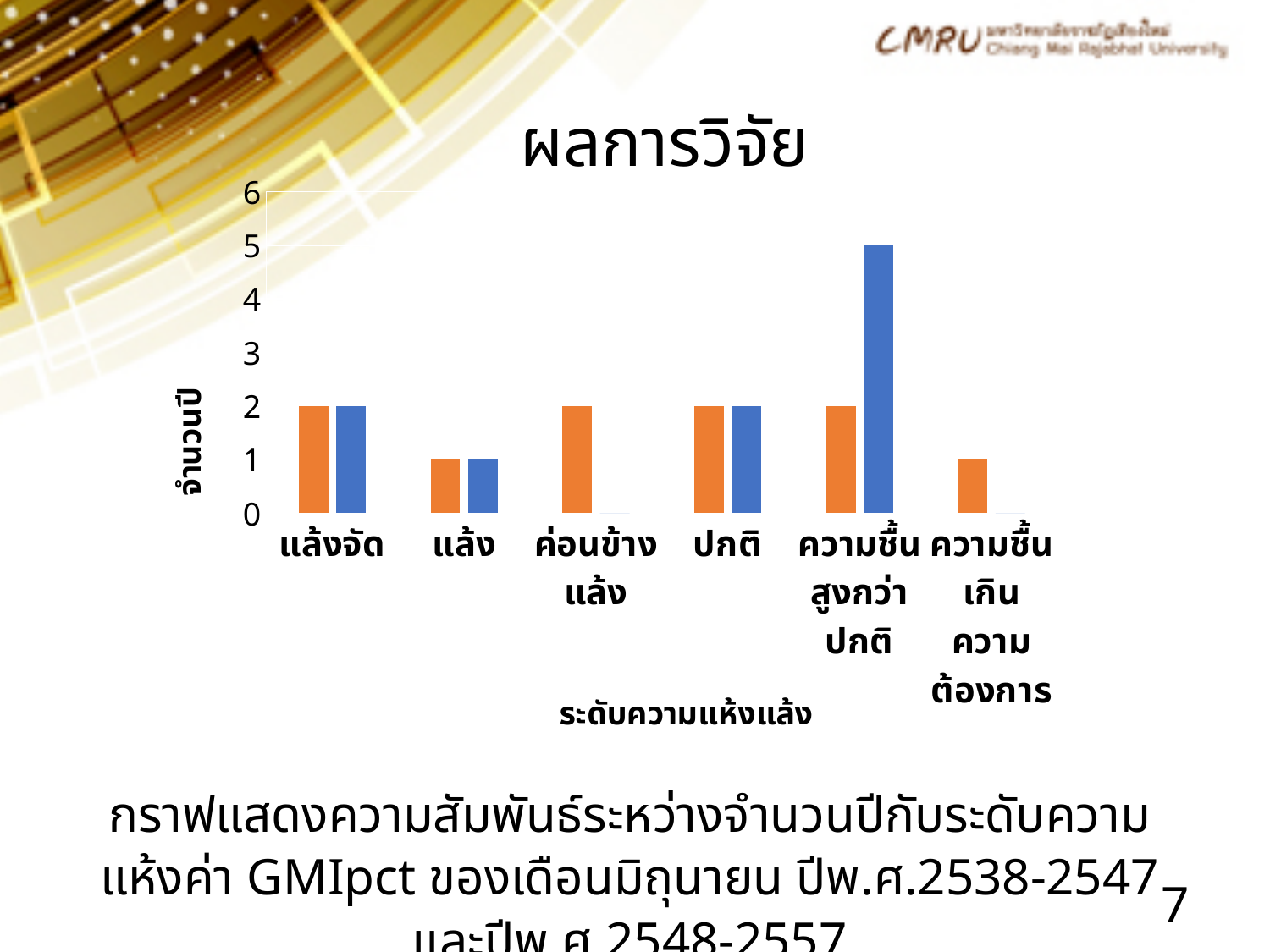
What is the difference between the blue bar and the orange bar for ความชื้นสูงกว่าปกติ? 3 Which category has the highest blue bar? ความชื้นสูงกว่าปกติ What is the value of the blue bar for แล้ง? 1 What kind of chart is shown on the slide? bar chart What is the title of the y axis of the chart? จำนวนปี What is the value of the blue bar for ความชื้นสูงกว่าปกติ? 5 Which is larger for ปกติ: the orange bar or the blue bar? They are equal What is the value of the orange bar for ความชื้นเกินความต้องการ? 1 What is the title of the x axis of the chart? ระดับความแห้งแล้ง How many categories are shown on the x axis of the chart? 6 Is the blue bar for ความชื้นสูงกว่าปกติ greater or less than 4? greater What is the value of the orange bar for แล้งจัด? 2